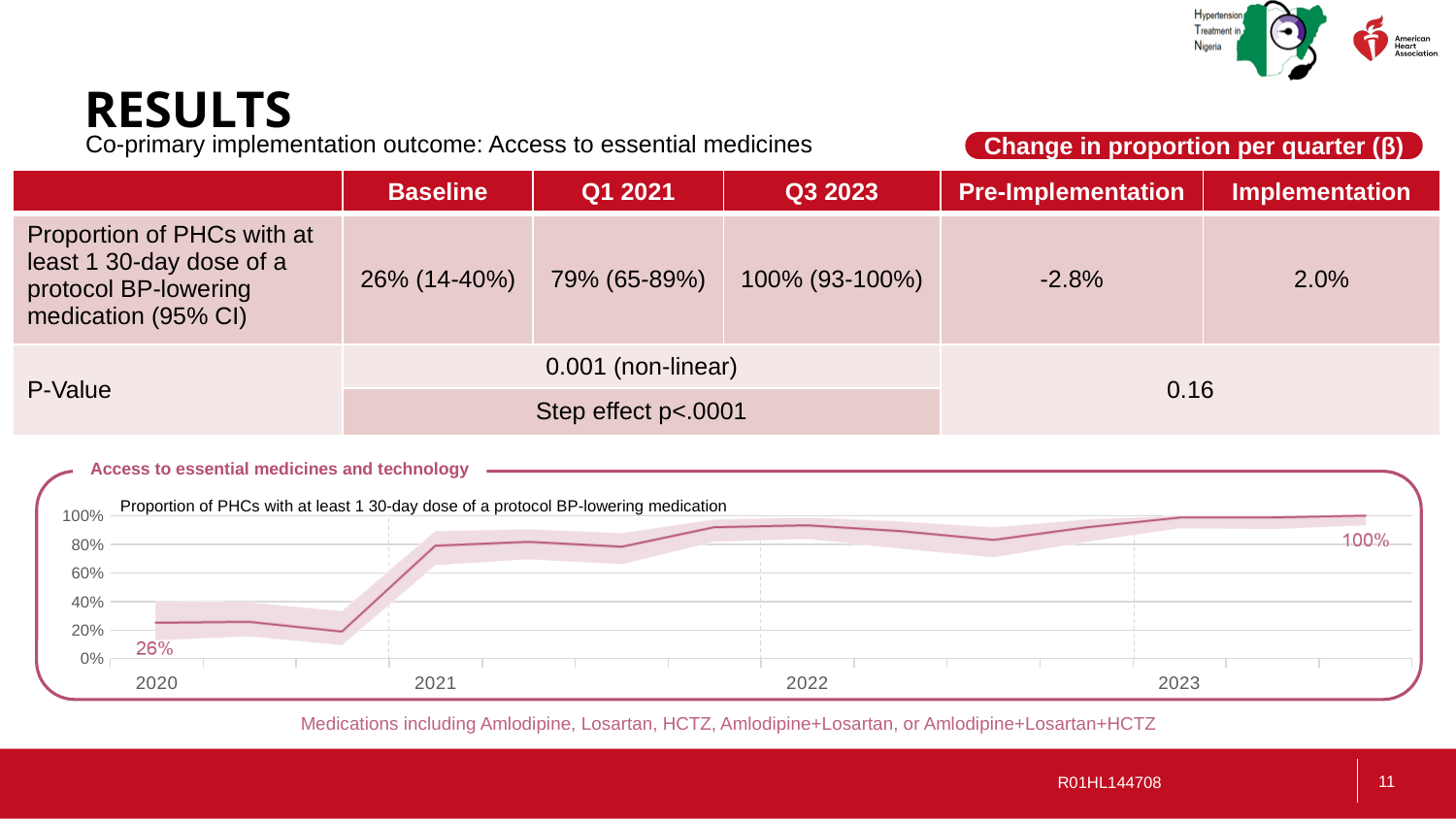
Does the proportion of PHCs rise or fall from 2020 to 2023? rise How many years are labelled on the x axis of the chart? 4 What kind of chart is shown on the slide? line chart What is the title printed above the line chart? Proportion of PHCs with at least 1 30-day dose of a protocol BP-lowering medication Is the value at the 2021 tick greater or less than 60%? greater What is the highest value labelled on the y axis of the chart? 100% What value is labelled at the end of the line in 2023? 100% Which is larger, the labelled value in 2020 or the labelled value in 2023? 2023 Is the value at the 2022 tick greater or less than 80%? greater What value is labelled at the start of the line in 2020? 26% Which labelled point on the line has the highest value? 2023 (100%) By how many percentage points does the labelled 2023 value exceed the labelled 2020 value? 74 percentage points